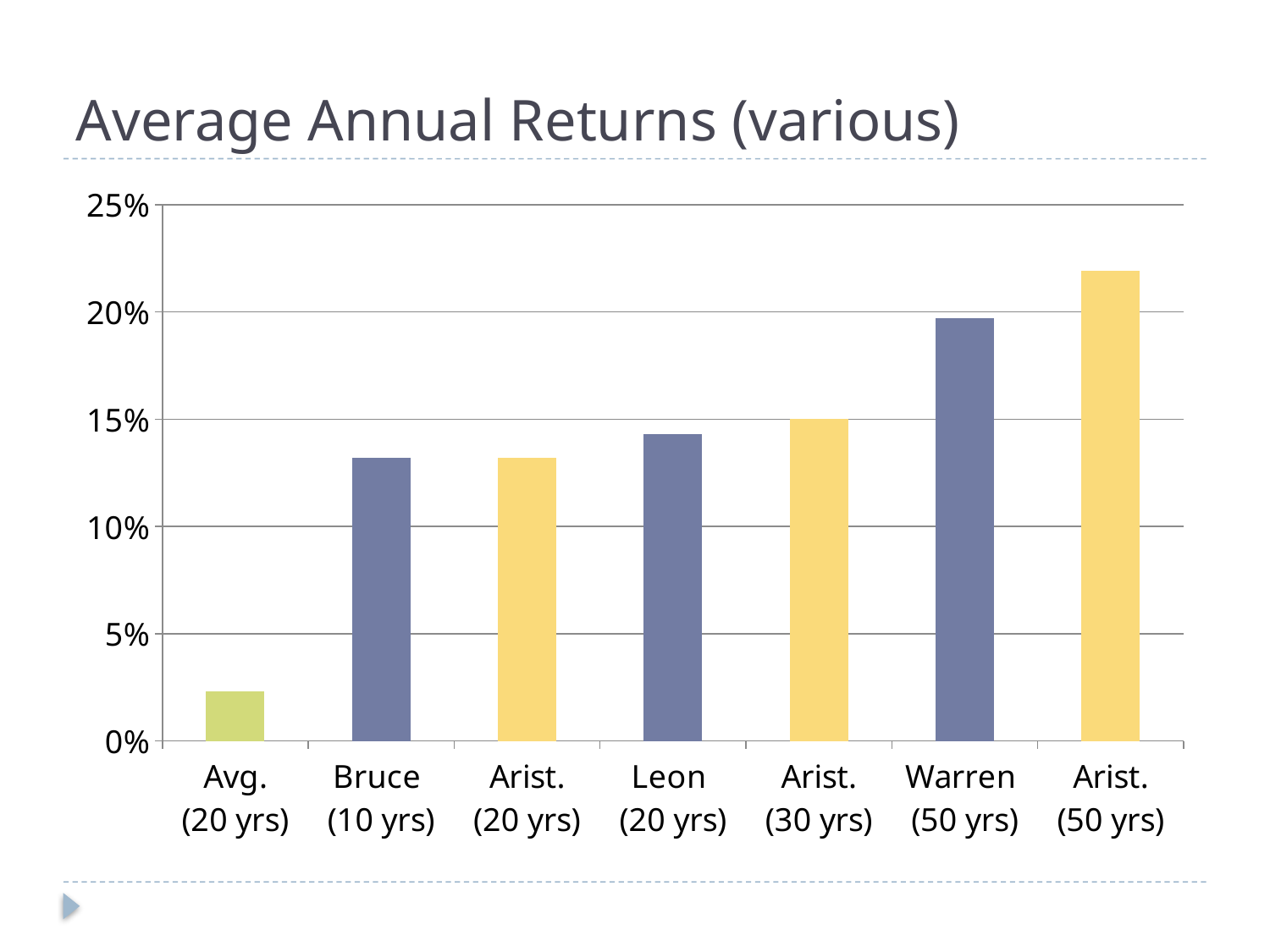
Is the value for Warren (50 yrs) greater or less than 15%? greater Is the value for Avg. (20 yrs) greater or less than 5%? less What is the title of the slide containing the chart? Average Annual Returns (various) Is the value for Leon (20 yrs) greater or less than 15%? less What kind of chart is shown on the slide? bar chart How many bars (categories) are plotted in the chart? 7 Which category has the lowest average annual return? Avg. (20 yrs) Which is larger, the value for Arist. (50 yrs) or the value for Warren (50 yrs)? Arist. (50 yrs) Which is larger, the value for Warren (50 yrs) or the value for Leon (20 yrs)? Warren (50 yrs) Which category has the highest average annual return? Arist. (50 yrs)